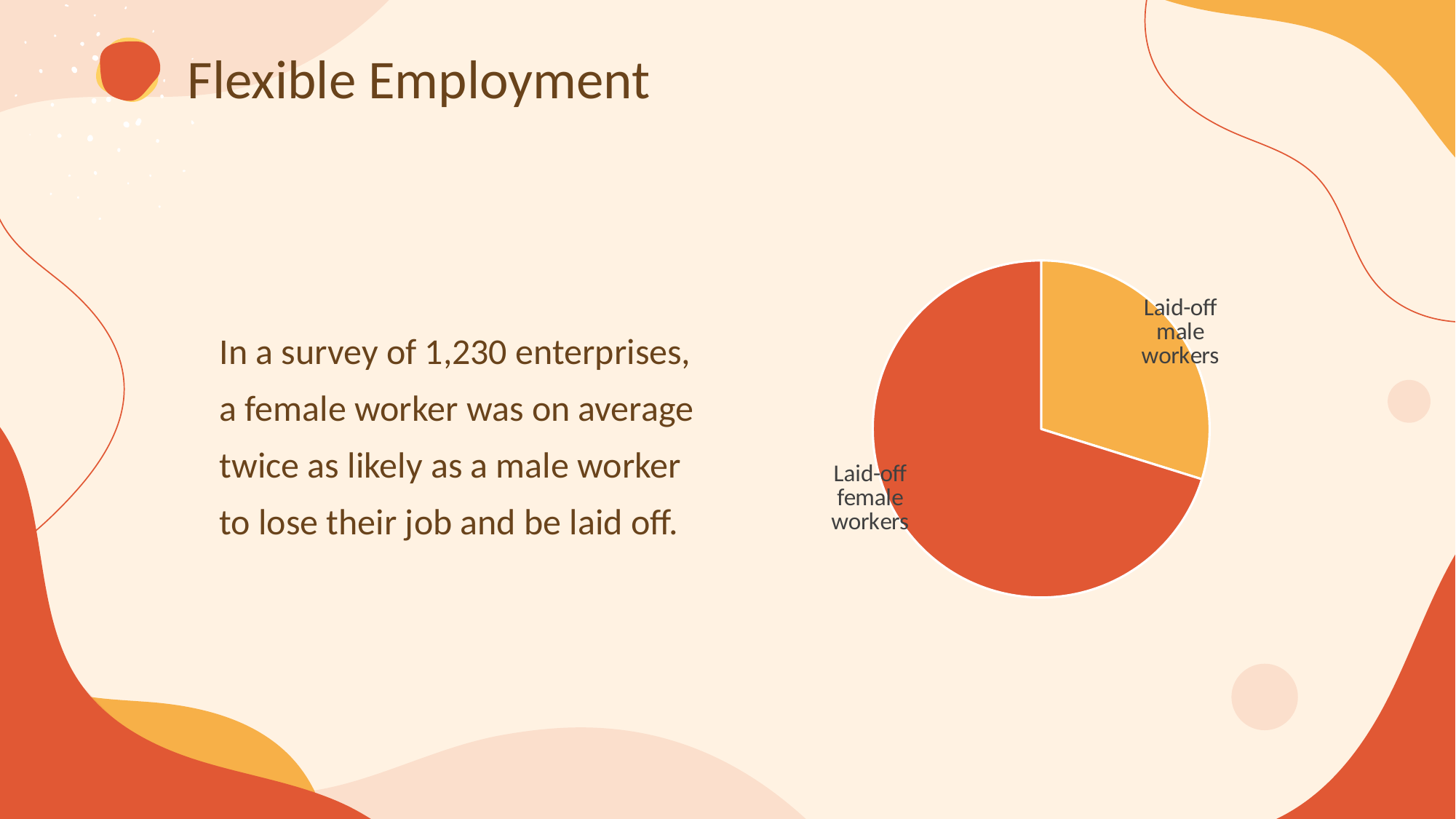
What colour is the Laid-off male workers slice in the pie chart? orange What kind of chart is shown on the slide? pie chart Which slice of the pie chart is the largest? Laid-off female workers What colour is the Laid-off female workers slice in the pie chart? red Which slice of the pie chart is the smallest? Laid-off male workers How many slices does the pie chart have? 2 Which slice is larger in the pie chart, Laid-off male workers or Laid-off female workers? Laid-off female workers